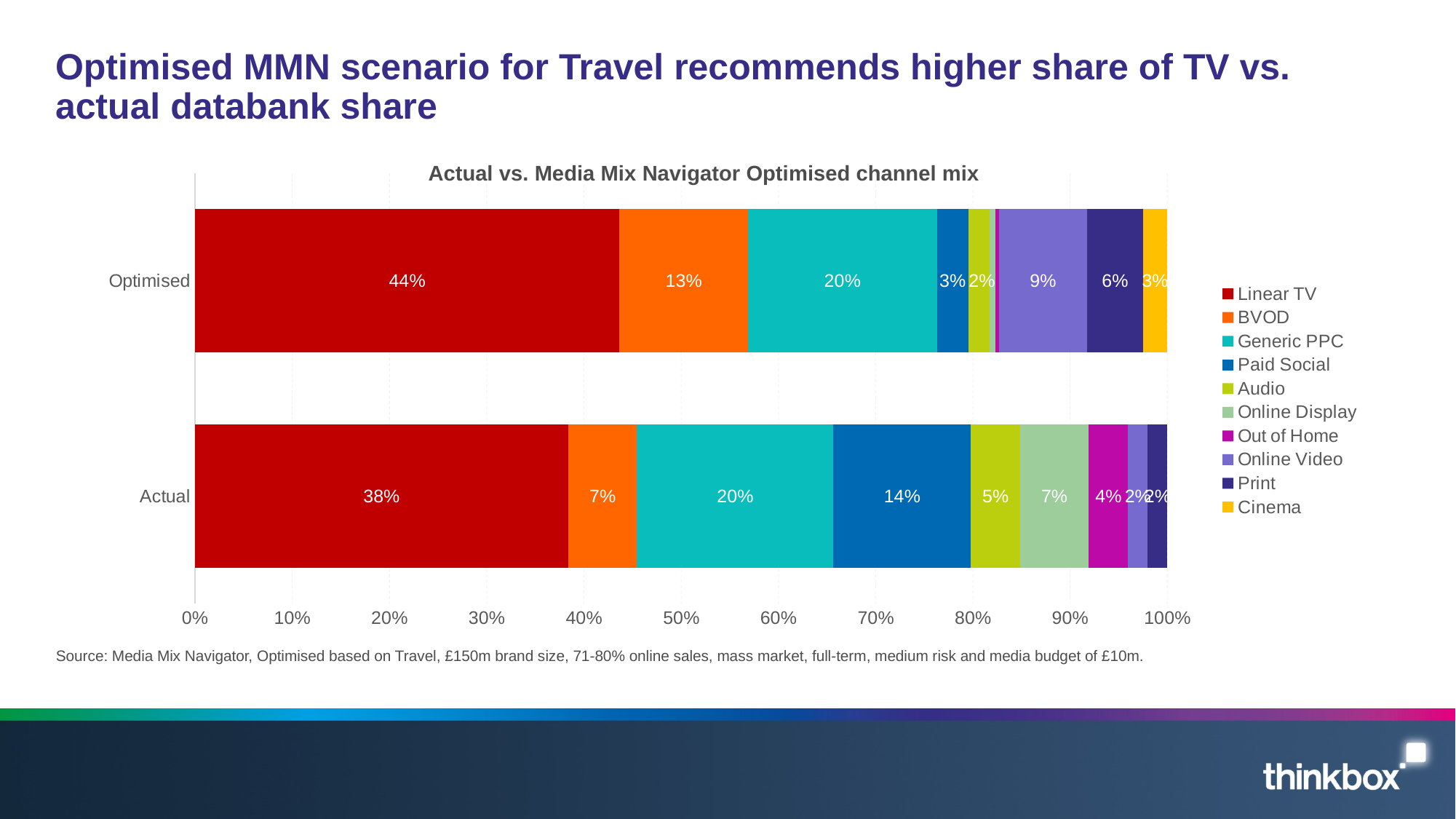
What kind of chart is shown on the slide? Stacked bar chart What is the Online Video share in the Optimised bar? 9% How many bars (categories) are plotted on the chart? 2 What is the Linear TV share in the Optimised bar? 44% Which series has the largest share in the Actual bar? Linear TV What is the Paid Social share in the Actual bar? 14% What is the BVOD share in the Optimised bar? 13% By how many percentage points is the Linear TV share higher in the Optimised bar than in the Actual bar? 6 percentage points What is the Linear TV share in the Actual bar? 38% What is the title of the chart? Actual vs. Media Mix Navigator Optimised channel mix Which bar has the larger Paid Social share, Optimised or Actual? Actual How many series does the legend list? 10